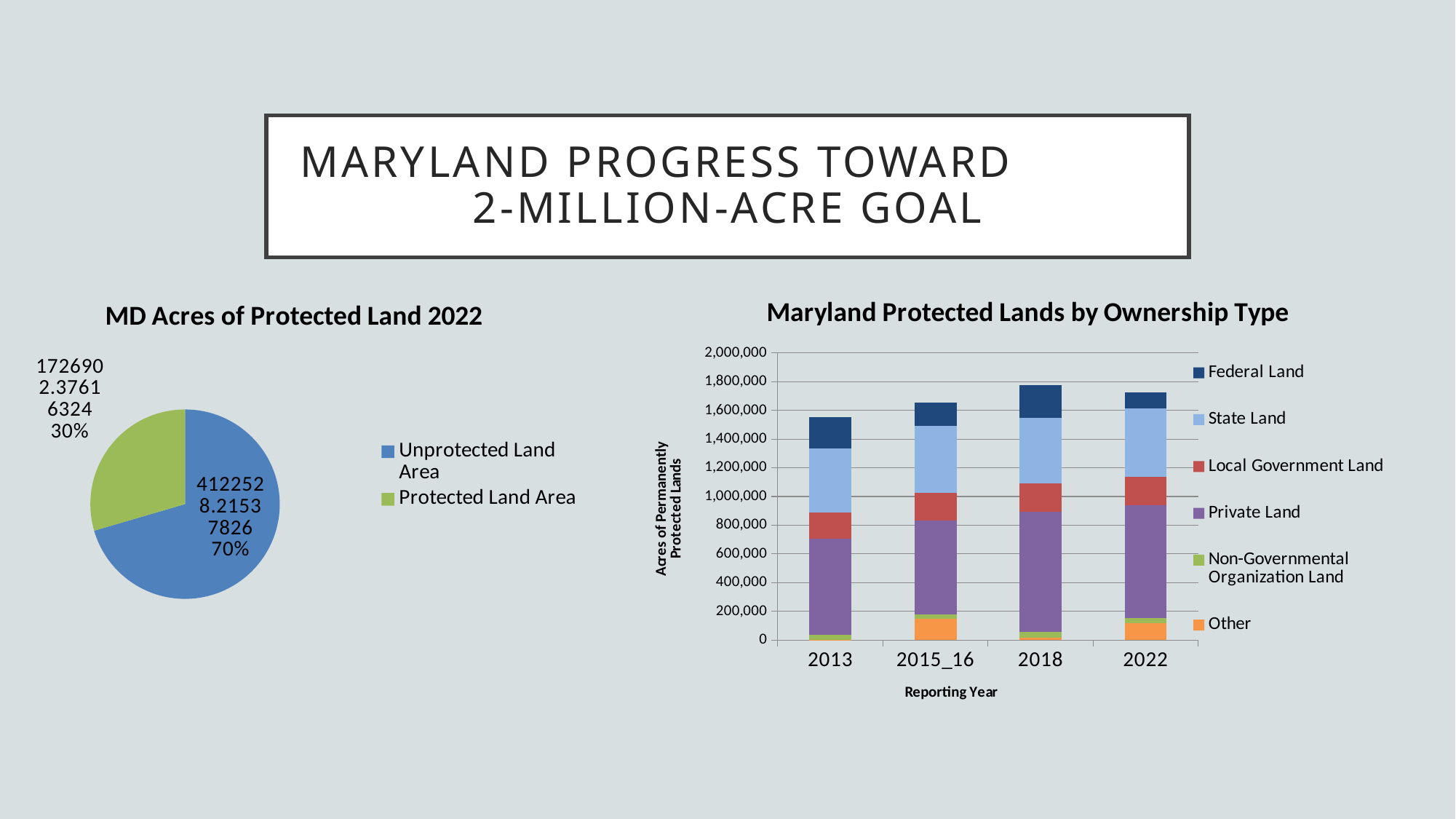
In 'Maryland Protected Lands by Ownership Type', is the total for 2013 greater or less than 1,400,000? greater In the pie chart 'MD Acres of Protected Land 2022', which slice is larger, Unprotected Land Area or Protected Land Area? Unprotected Land Area How many slices does the pie chart 'MD Acres of Protected Land 2022' have? 2 What is the x-axis title of the chart 'Maryland Protected Lands by Ownership Type'? Reporting Year In the pie chart 'MD Acres of Protected Land 2022', what percentage share is shown for Unprotected Land Area? 70% In 'Maryland Protected Lands by Ownership Type', is the total for 2022 greater or less than 1,800,000? less How many reporting years are shown on the x axis of 'Maryland Protected Lands by Ownership Type'? 4 What type of chart is 'MD Acres of Protected Land 2022'? Pie chart In 'Maryland Protected Lands by Ownership Type', which reporting year has the lowest total acres of permanently protected lands? 2013 In the pie chart 'MD Acres of Protected Land 2022', what percentage share is shown for Protected Land Area? 30% How many series does the legend of 'Maryland Protected Lands by Ownership Type' list? 6 What type of chart is 'Maryland Protected Lands by Ownership Type'? Stacked bar chart